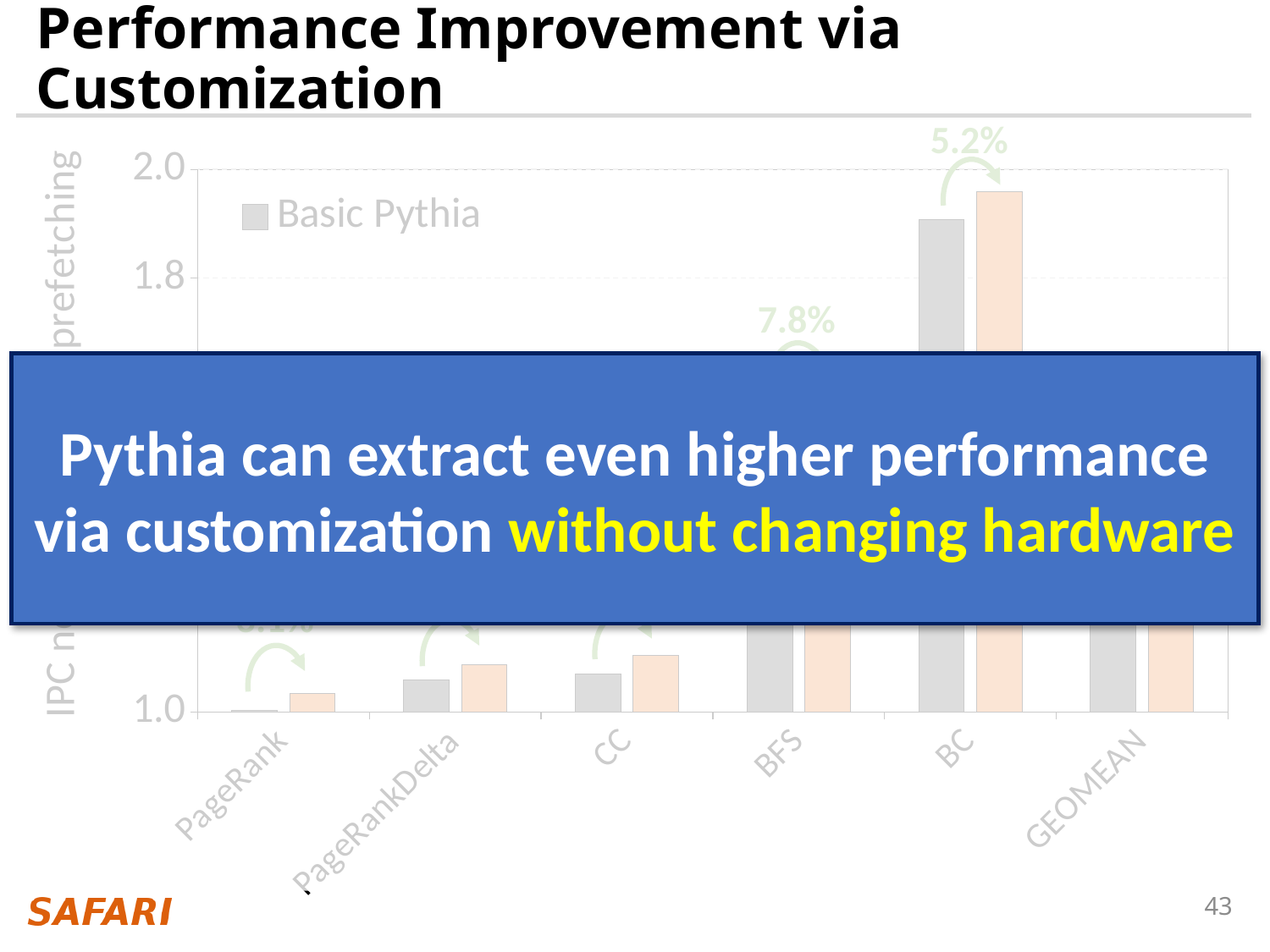
Which series name is visible in the chart's legend? Basic Pythia Is the Basic Pythia value for CC greater or less than 1.8? less Which category has the highest Basic Pythia bar? BC What kind of chart is shown on the slide? bar chart How many categories are shown on the x axis of the chart? 6 Which has the larger Basic Pythia bar, PageRank or CC? CC Which category is annotated with the 7.8% label? BFS What percentage improvement is annotated above the BC bars? 5.2% Is the Basic Pythia value for BC greater or less than 1.8? greater What percentage improvement is annotated above the BFS bars? 7.8% Which category has the lowest Basic Pythia bar? PageRank